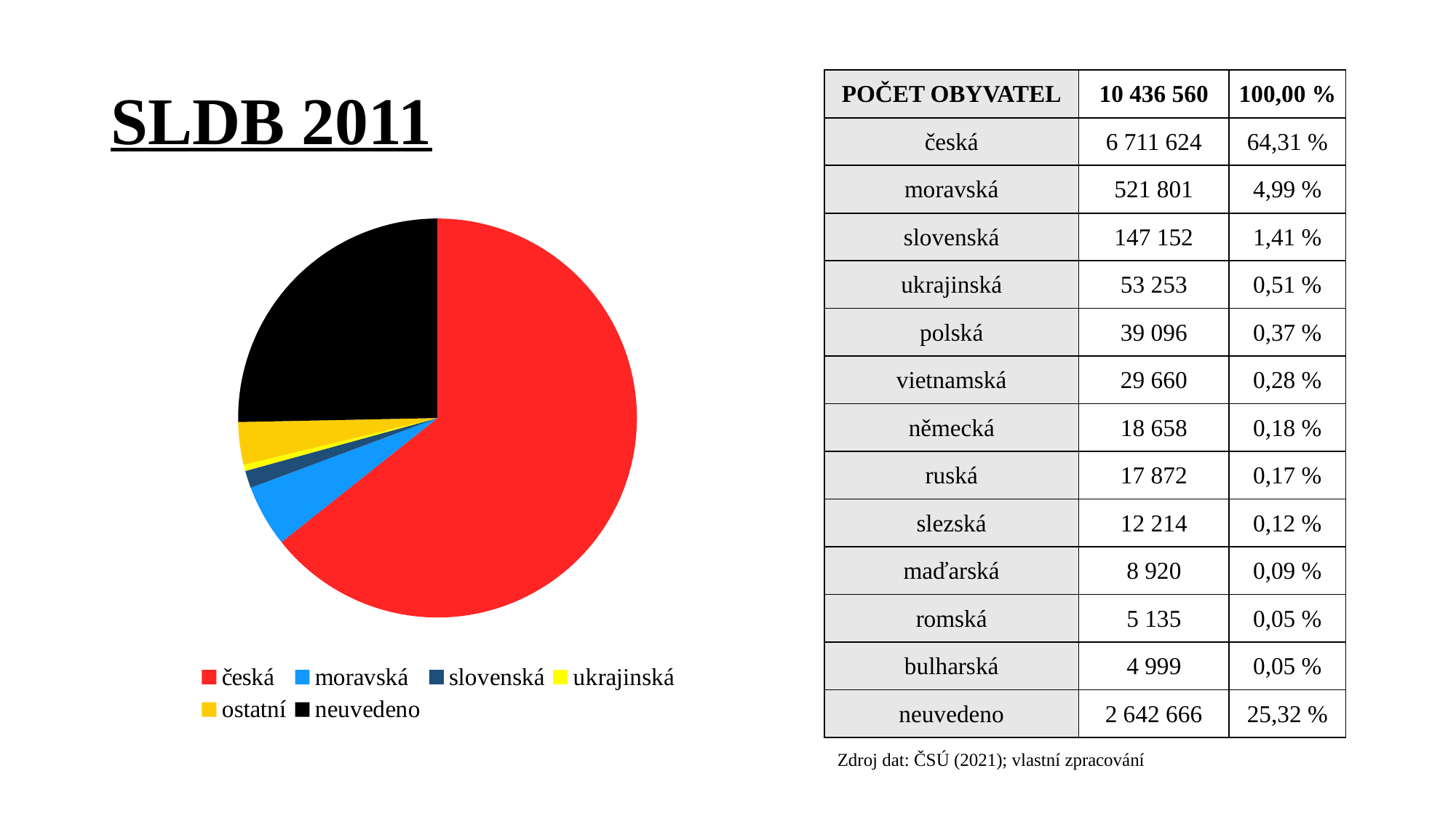
What colour is the česká slice in the pie chart? red Which category has the smallest slice in the pie chart? ukrajinská Which slice is larger in the pie chart, moravská or slovenská? moravská According to the slide, what share of the population does the moravská slice represent? 4,99 % How many slices does the pie chart have? 6 Which slice is larger in the pie chart, neuvedeno or moravská? neuvedeno According to the slide, what share of the population does the neuvedeno slice represent? 25,32 % What kind of chart is shown on the slide? pie chart According to the slide, what share of the population does the česká slice represent? 64,31 % Which category has the largest slice in the pie chart? česká What is the population count for the slovenská category shown on the slide? 147 152 What colour is the neuvedeno slice in the pie chart? black